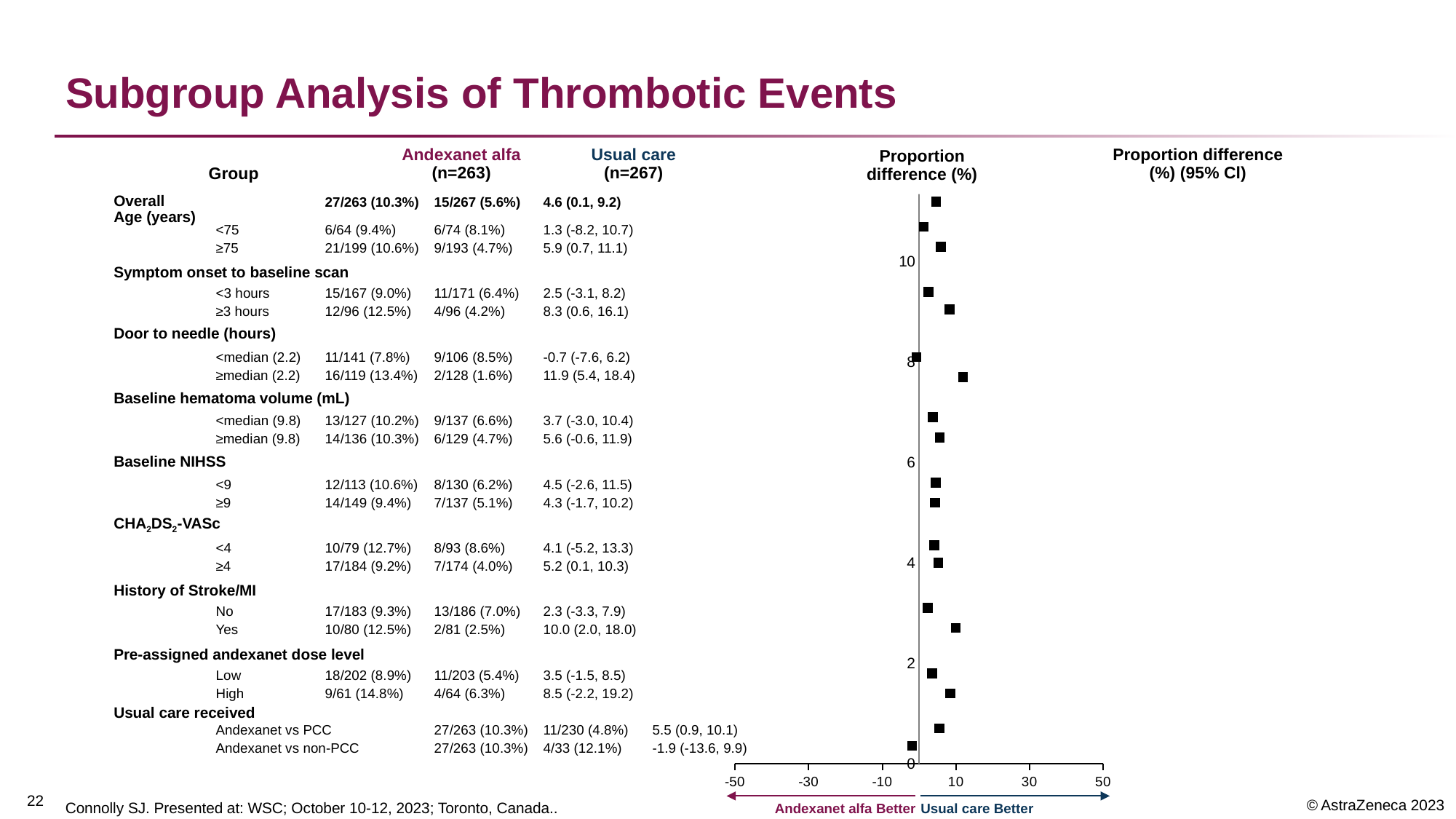
Which has the larger proportion difference: symptom onset to baseline scan <3 hours or ≥3 hours? ≥3 hours Is the proportion difference for door to needle ≥median (2.2) greater or less than 10? greater What is the overall proportion difference (%) shown on the forest plot? 4.6 What kind of chart is shown on the slide? forest plot Which subgroup has the lowest proportion difference on the forest plot? Andexanet vs non-PCC What is the proportion difference (%) for patients with a history of stroke/MI (Yes)? 10.0 What does the left-pointing arrow below the x axis of the forest plot indicate? Andexanet alfa Better What is the difference between the proportion difference for age ≥75 and age <75? 4.6 What is the proportion difference (%) for Andexanet vs PCC? 5.5 How many subgroup points are plotted on the forest plot? 19 Which subgroup has the highest proportion difference on the forest plot? Door to needle ≥median (2.2) Which pre-assigned andexanet dose level has the larger proportion difference, Low or High? High